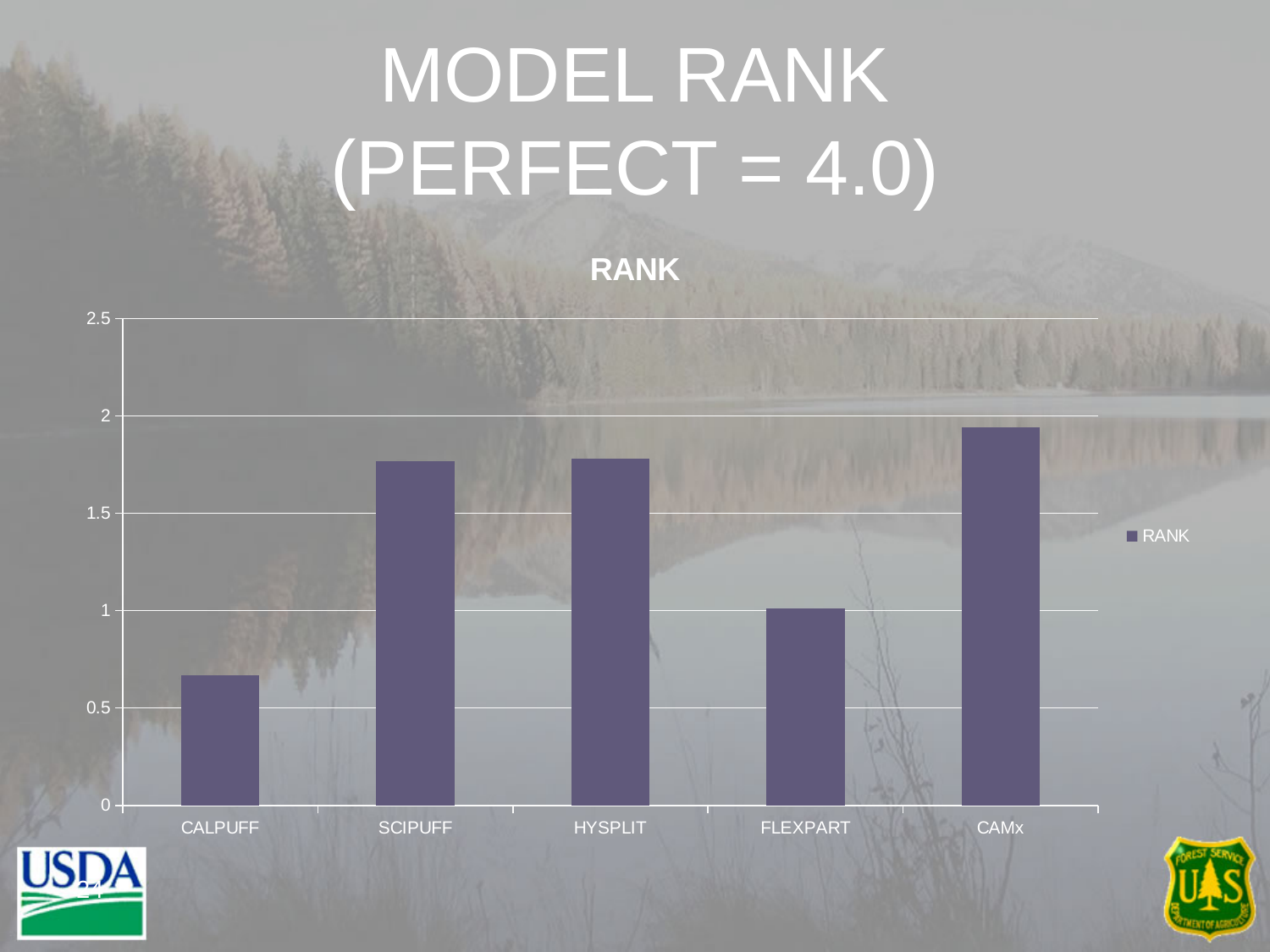
How many models (categories) are shown on the x axis of the RANK chart? 5 What is the title of the chart on the slide? RANK Is the rank for CALPUFF greater or less than 0.5? greater Which model has the lowest rank in the chart? CALPUFF Which model has the highest rank in the chart? CAMx Is the rank for SCIPUFF greater or less than 1.5? greater What kind of chart is shown on the slide? bar chart Which has a higher rank, FLEXPART or CALPUFF? FLEXPART Which has a higher rank, CAMx or SCIPUFF? CAMx How many series does the legend of the RANK chart list? 1 Is the rank for HYSPLIT greater or less than 2? less